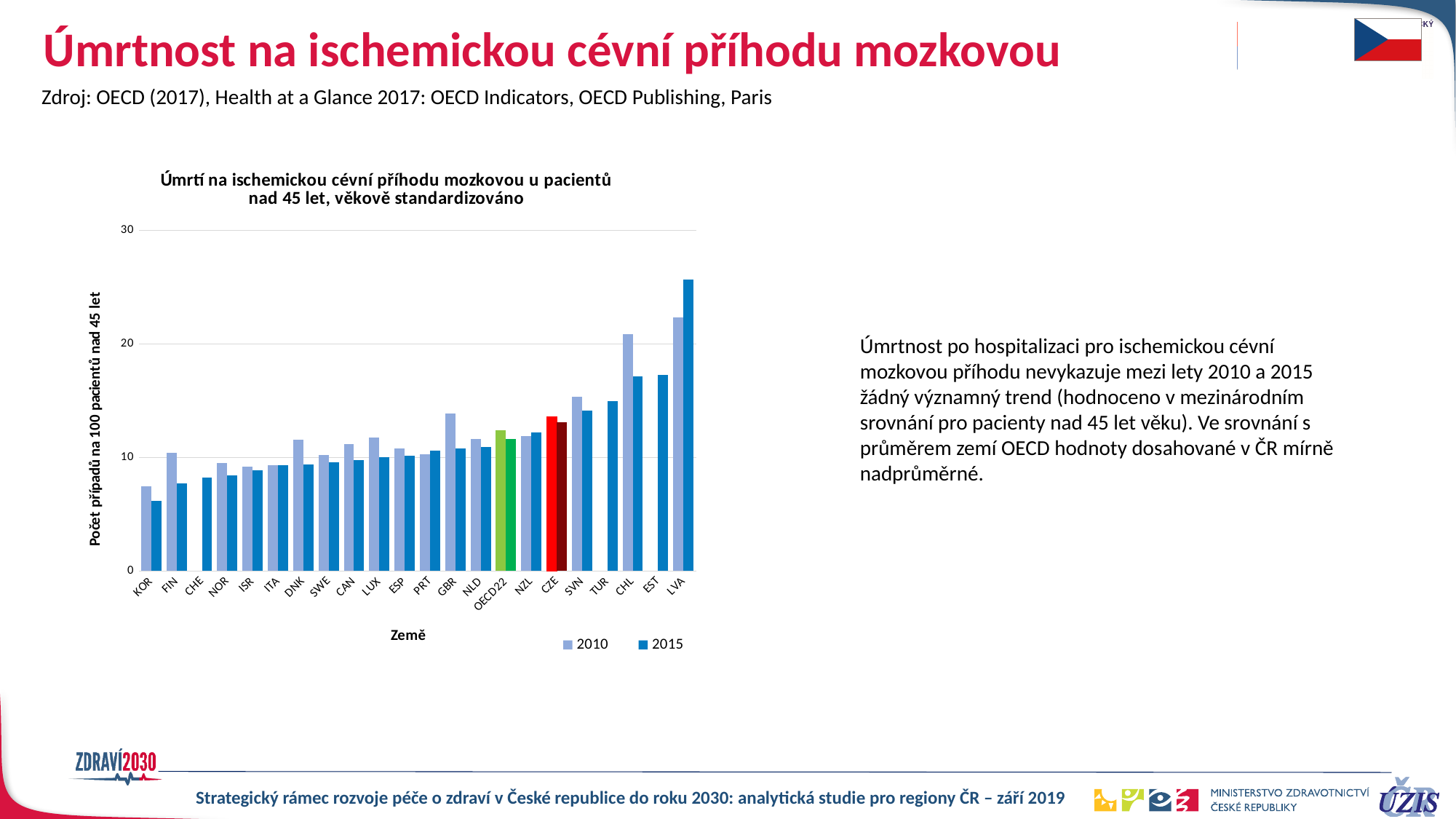
How many series does the chart legend list? 2 Is the 2015 value for KOR greater or less than 10? less Which category has the lowest 2015 value in the chart? KOR What kind of chart is shown on the slide? bar chart Is the 2010 value for CHL greater or less than 20? greater Which category has the highest 2015 value in the chart? LVA Which two series are listed in the chart legend? 2010 and 2015 Which has the larger 2015 value, CZE or OECD22? CZE Is the 2015 value for CZE greater or less than 10? greater Do the 2015 values generally rise or fall moving from left to right along the x axis? rise How many countries/categories are shown on the x axis of the chart? 22